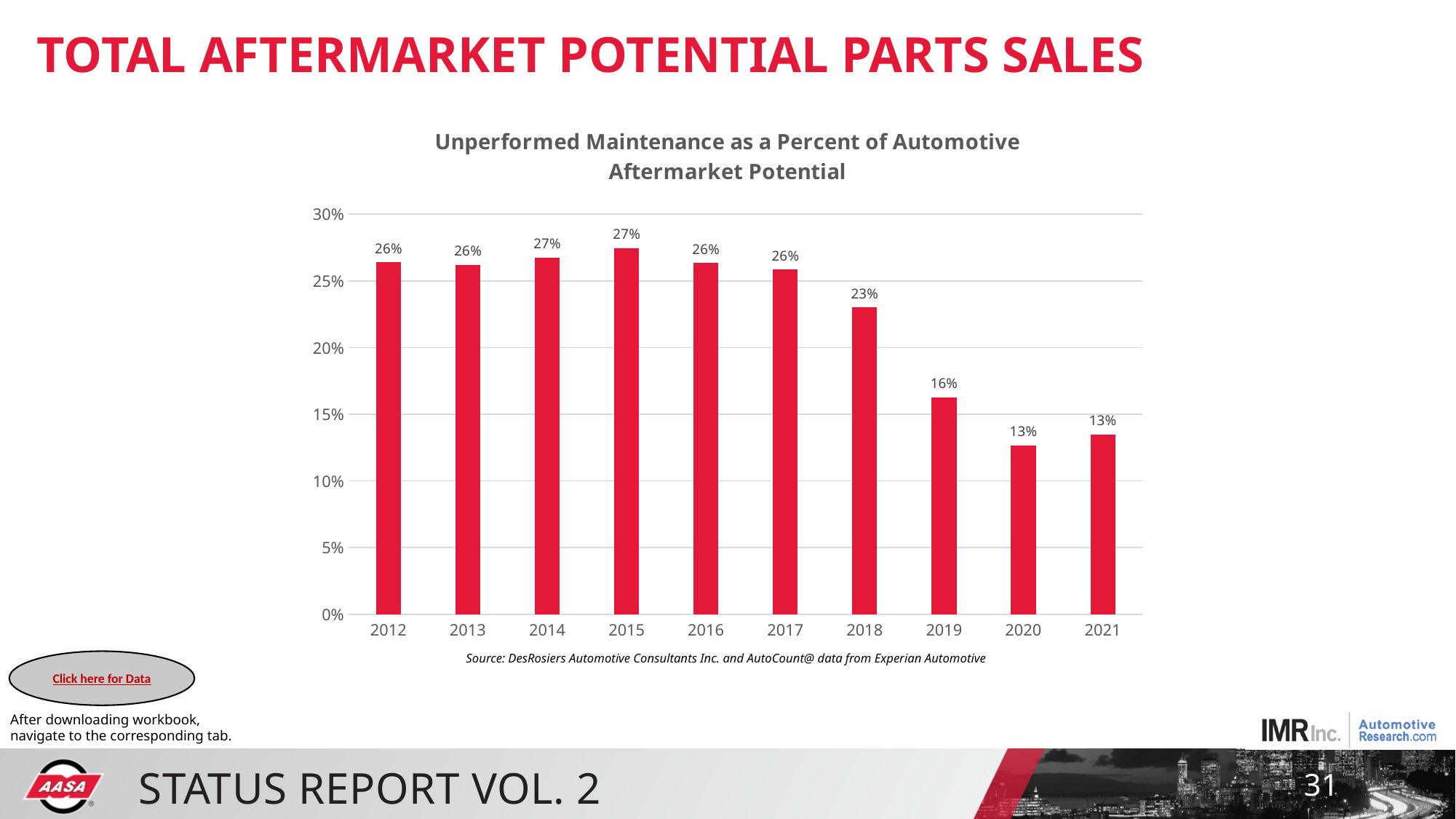
How many years are shown on the x axis of the chart? 10 What is the value for 2019 in the chart? 16% What is the value for 2018 in the chart? 23% Which is larger, the value for 2017 or the value for 2019? 2017 What is the difference between the values for 2015 and 2021? 14% Do the values generally rise or fall from 2012 to 2021? Fall What is the difference between the values for 2018 and 2019? 7% Is the value for 2020 greater or less than 15%? less What is the value for 2020 in the chart? 13% What kind of chart is shown on the slide? Bar chart What is the value for 2012 in the chart? 26% Is the value for 2018 greater or less than 20%? greater